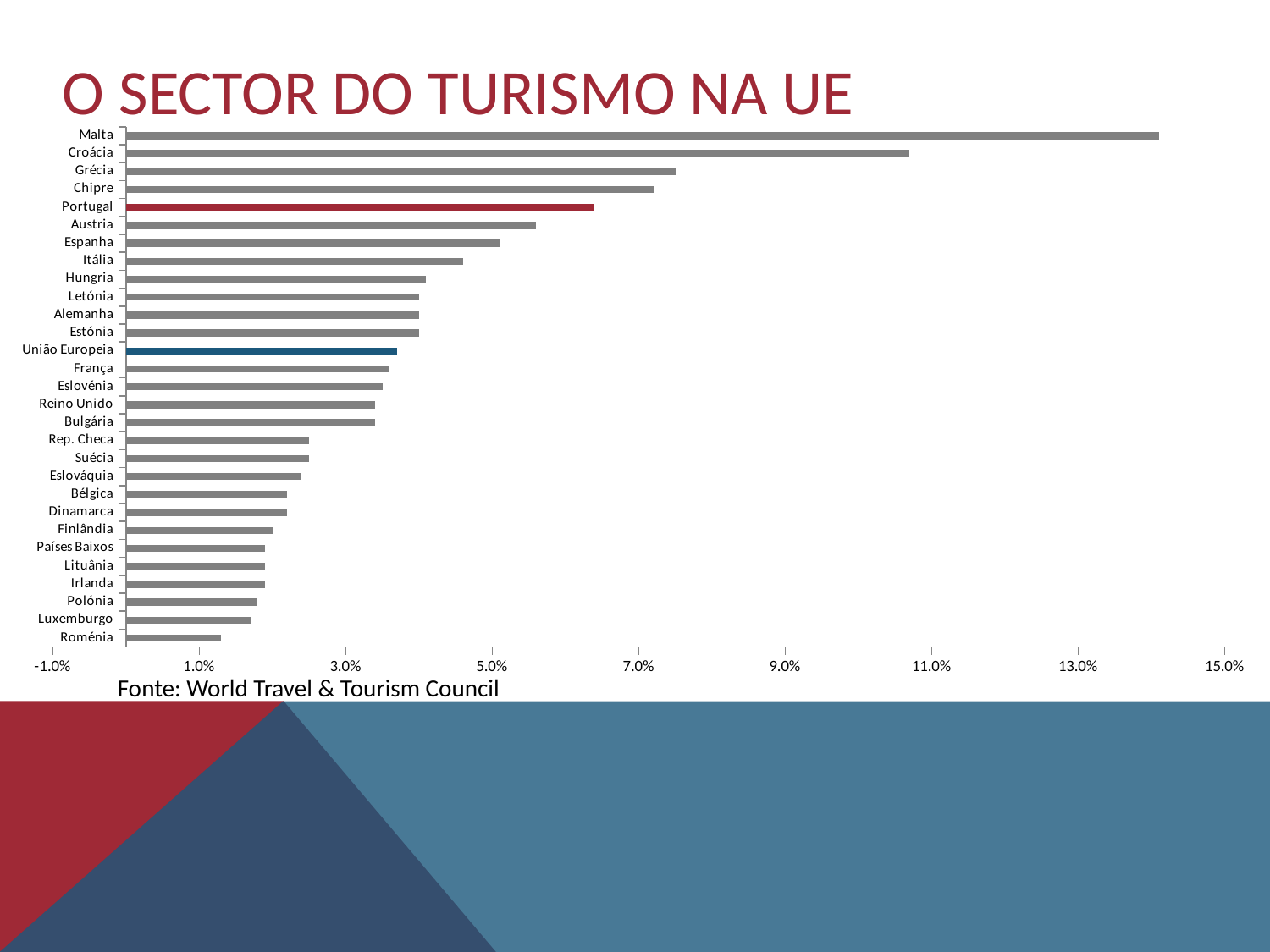
Is the value for União Europeia greater or less than 3.0%? greater Do the bar values increase or decrease going from the top category (Malta) to the bottom category (Roménia)? decrease What colour is the bar for Portugal? red Is the value for Rep. Checa greater or less than 3.0%? less Which has the larger value, Portugal or Espanha? Portugal What kind of chart is shown on the slide? bar chart Which category has the lowest value in the chart? Roménia How many categories (bars) are plotted in the chart? 29 Is the value for Malta greater or less than 13.0%? greater Which country has the highest value in the chart? Malta